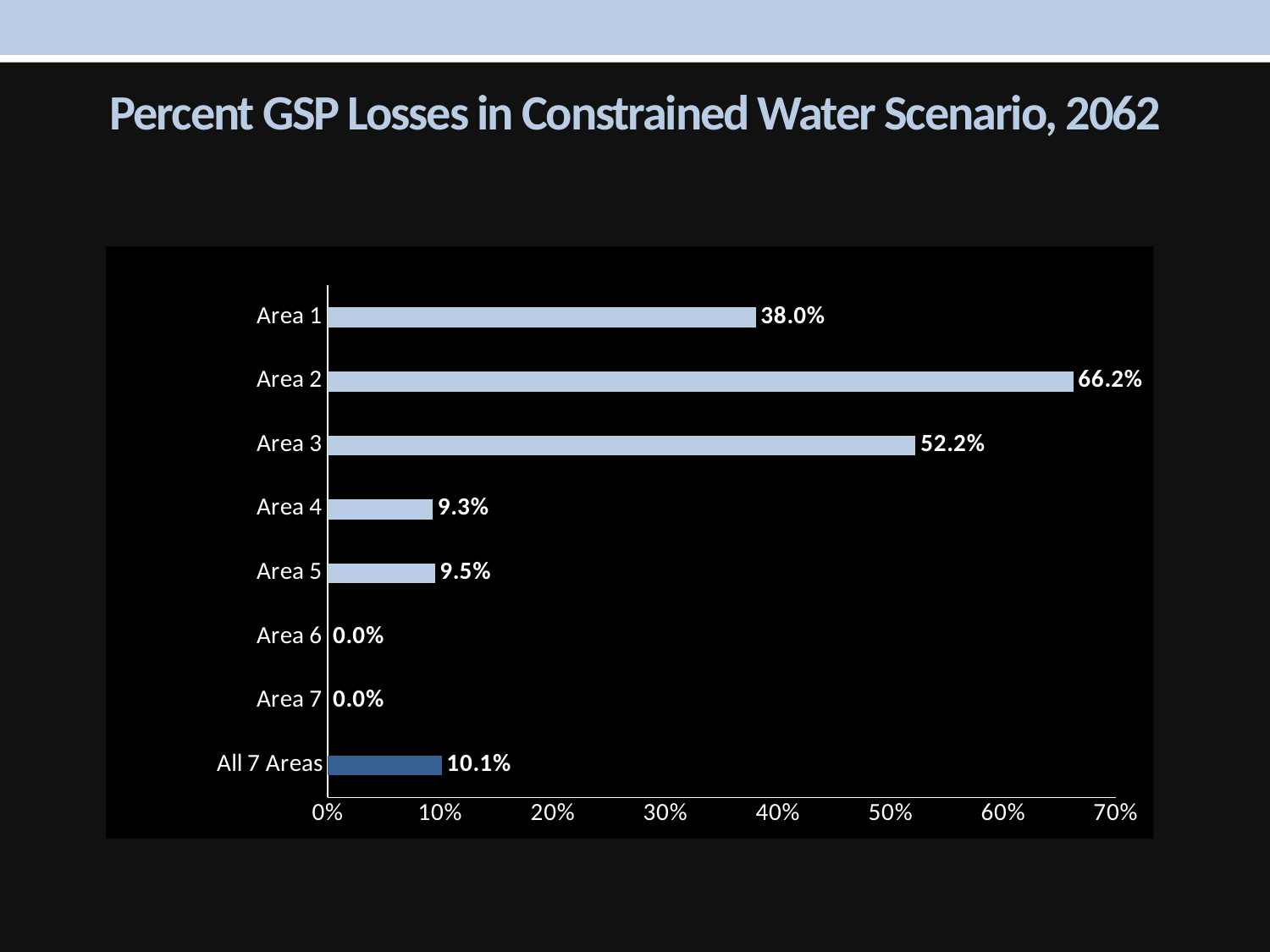
What is the percent GSP loss for Area 2? 66.2% What is the percent GSP loss for All 7 Areas? 10.1% What kind of chart is shown on the slide? Bar chart What is the difference between the percent GSP losses of Area 1 and All 7 Areas? 27.9% Which has a larger percent GSP loss, Area 3 or Area 1? Area 3 Is the value for Area 3 greater or less than 50%? greater What is the percent GSP loss for Area 4? 9.3% What is the percent GSP loss for Area 1? 38.0% Which area has the highest percent GSP loss? Area 2 What is the title of the chart? Percent GSP Losses in Constrained Water Scenario, 2062 What is the difference between the percent GSP losses of Area 2 and Area 3? 14.0% How many categories are shown on the chart? 8